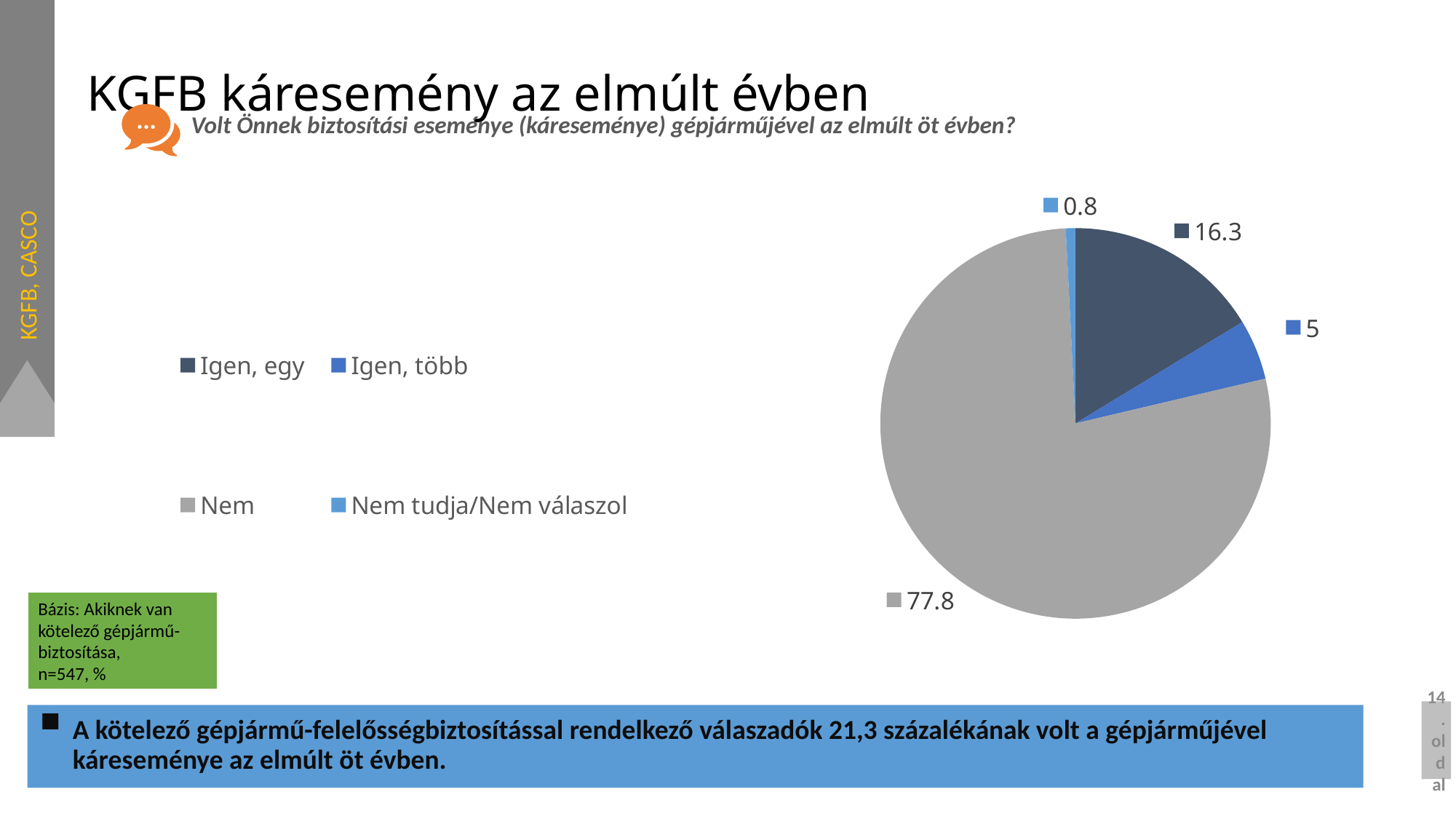
How many entries does the legend list? 4 Which is larger, the value for "Igen, egy" or the value for "Igen, több"? Igen, egy What is the value for "Nem tudja/Nem válaszol" in the pie chart? 0.8 How many slices does the pie chart have? 4 Which category has the largest slice in the pie chart? Nem What is the value for "Igen, egy" in the pie chart? 16.3 Which category has the smallest slice in the pie chart? Nem tudja/Nem válaszol What is the difference between the values for "Nem" and "Igen, egy"? 61.5 What type of chart is shown on the slide? pie chart What is the difference between the values for "Igen, egy" and "Igen, több"? 11.3 What is the value for "Igen, több" in the pie chart? 5 What is the value for "Nem" in the pie chart? 77.8